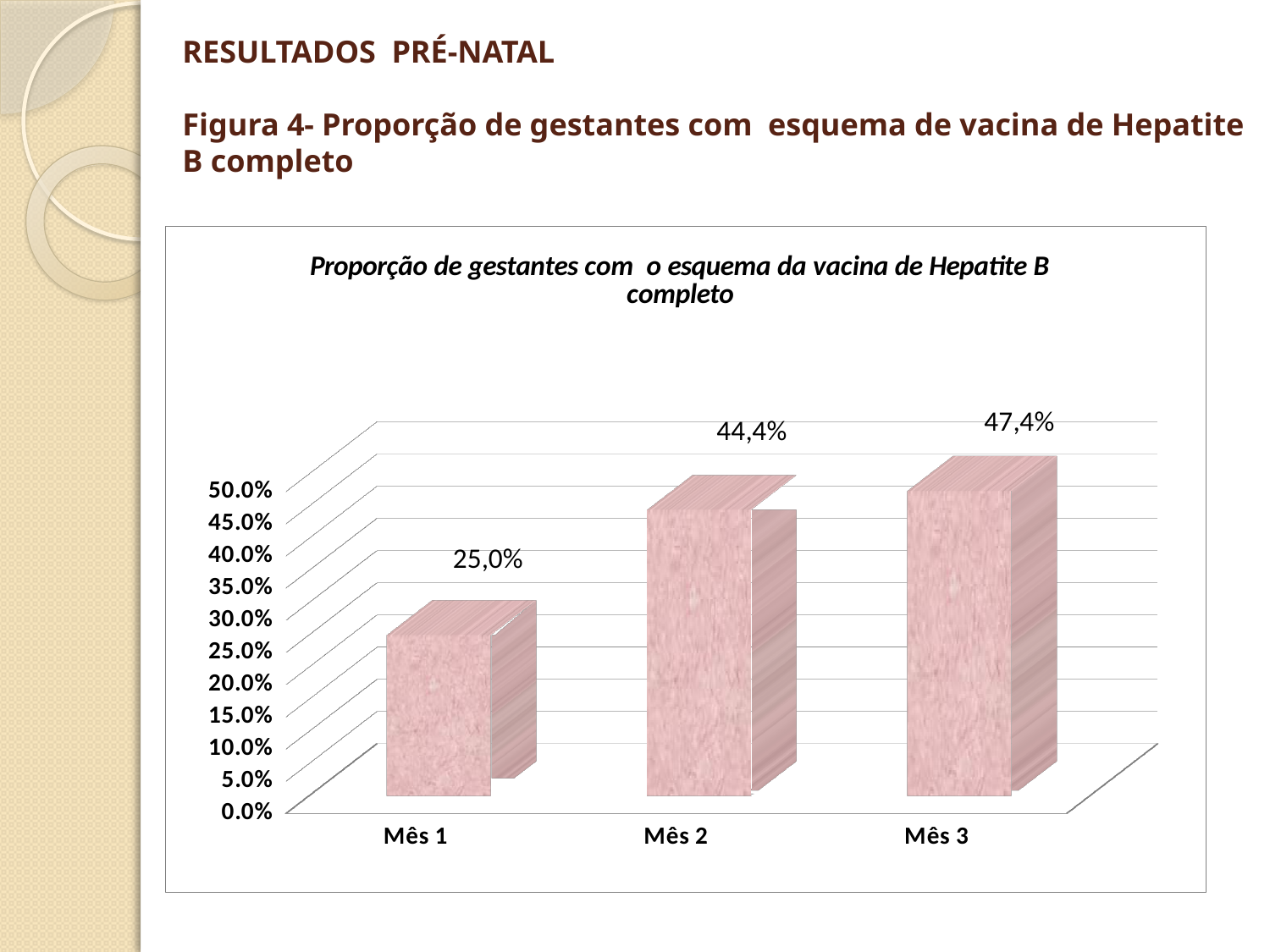
Which is larger, the value for Mês 1 or the value for Mês 2? Mês 2 What is the value for Mês 3? 47,4% What is the difference between the values for Mês 2 and Mês 1? 19,4% Do the values rise or fall from Mês 1 to Mês 3? rise Is the value for Mês 1 greater or less than 30.0%? less How many categories are shown on the x axis? 3 Which month has the highest proportion? Mês 3 Which month has the lowest proportion? Mês 1 What kind of chart is shown on the slide? bar chart What is the difference between the values for Mês 3 and Mês 1? 22,4% What is the value for Mês 2? 44,4% What is the value for Mês 1? 25,0%